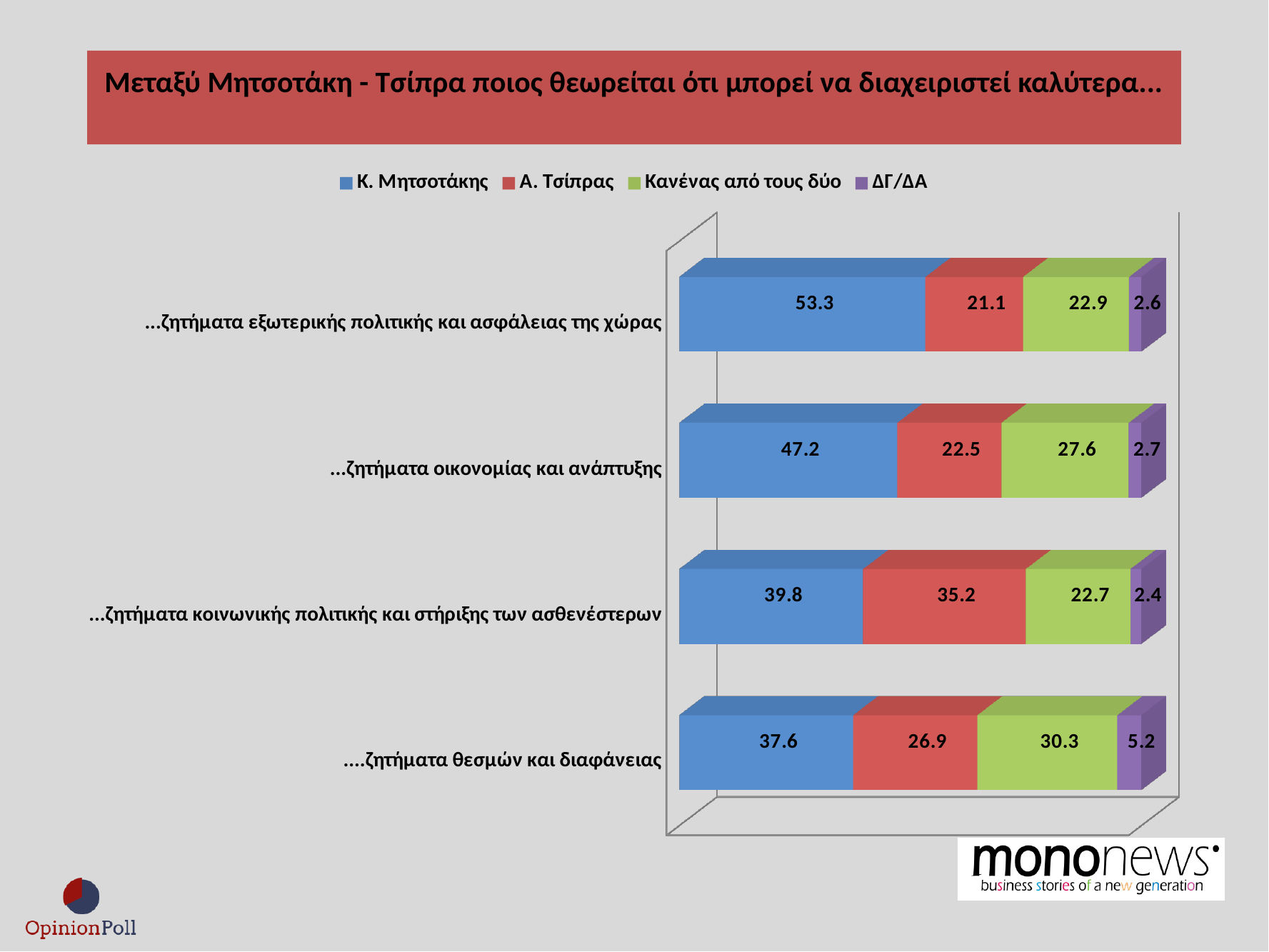
What is the value for Κ. Μητσοτάκης in the category '...ζητήματα εξωτερικής πολιτικής και ασφάλειας της χώρας'? 53.3 In which category does Κ. Μητσοτάκης have the highest value? ...ζητήματα εξωτερικής πολιτικής και ασφάλειας της χώρας What is the total of the stacked bar for '...ζητήματα οικονομίας και ανάπτυξης'? 100.0 What is the value for Α. Τσίπρας in the category '...ζητήματα κοινωνικής πολιτικής και στήριξης των ασθενέστερων'? 35.2 What is the value for ΔΓ/ΔΑ in the category '...ζητήματα οικονομίας και ανάπτυξης'? 2.7 How many categories (bars) are shown in the chart? 4 In which category does Α. Τσίπρας have the lowest value? ...ζητήματα εξωτερικής πολιτικής και ασφάλειας της χώρας What kind of chart is shown on the slide? stacked bar chart What is the value for Κανένας από τους δύο in the category '....ζητήματα θεσμών και διαφάνειας'? 30.3 What is the difference between the values for Κ. Μητσοτάκης and Α. Τσίπρας in the category '...ζητήματα εξωτερικής πολιτικής και ασφάλειας της χώρας'? 32.2 In the category '....ζητήματα θεσμών και διαφάνειας', which is larger: the value for Α. Τσίπρας or for Κανένας από τους δύο? Κανένας από τους δύο How many series does the legend list? 4